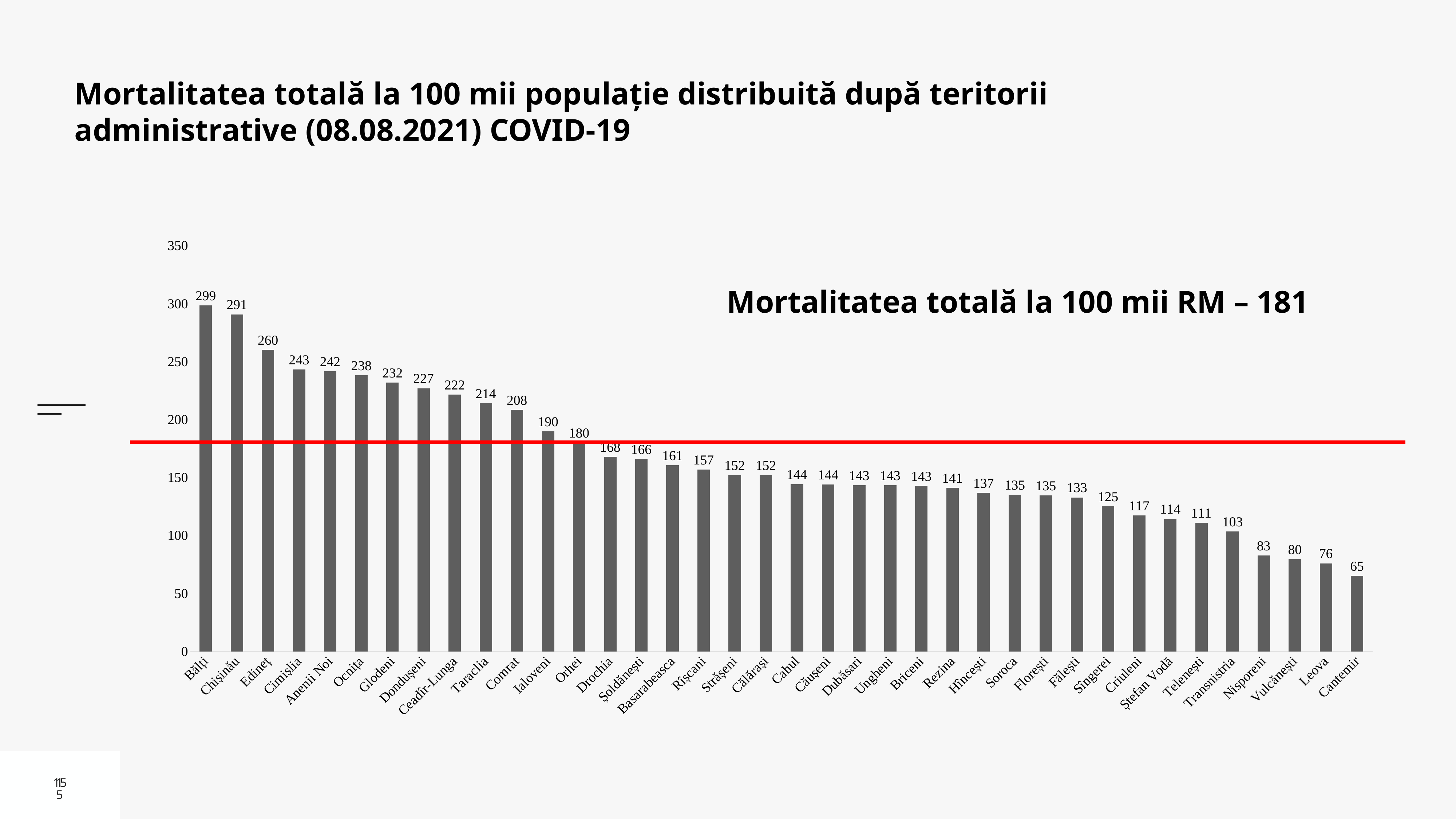
What is the value for Orhei? 180 Which territory has the lowest value? Cantemir What is the value for Transnistria? 103 Do the values rise or fall from left to right along the x axis? fall What kind of chart is shown on the slide? bar chart What is the difference between the values for Edineț and Drochia? 92 What is the difference between the values for Bălți and Cantemir? 234 What is the value for Chișinău? 291 Which territory has the highest value? Bălți Is the value for Ialoveni greater or less than 150? greater How many territories are shown on the chart? 38 Which has a larger value, Taraclia or Soroca? Taraclia